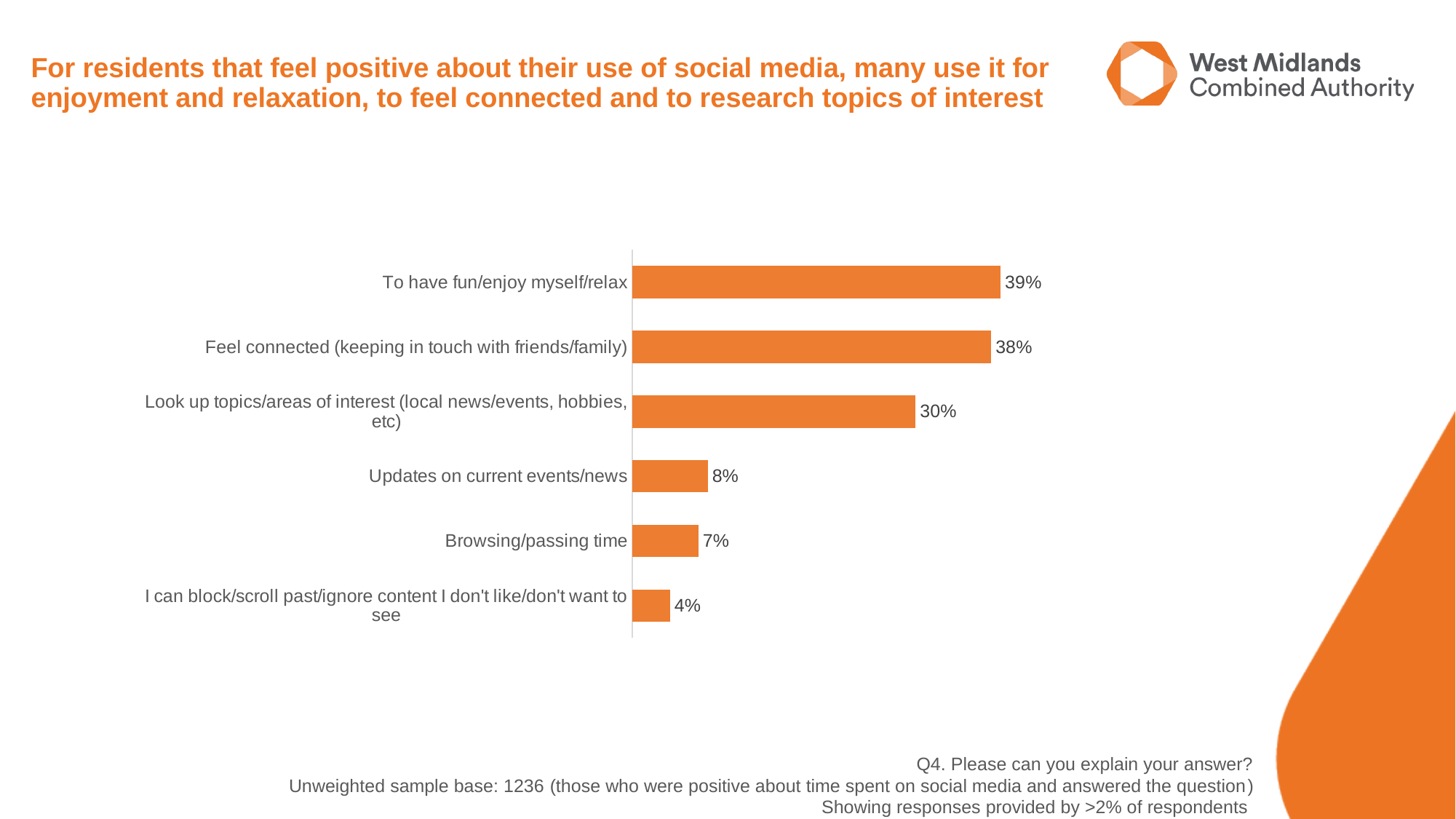
What is the value for 'Feel connected (keeping in touch with friends/family)'? 38% How many categories are shown in the chart? 6 What type of chart is shown on the slide? Bar chart Which category has the lowest value? I can block/scroll past/ignore content I don't like/don't want to see What is the unweighted sample base stated on the slide? 1236 Which category has the highest value? To have fun/enjoy myself/relax What is the difference between 'Updates on current events/news' and 'I can block/scroll past/ignore content I don't like/don't want to see'? 4% Which is larger: the value for 'Updates on current events/news' or 'Browsing/passing time'? Updates on current events/news What percentage of respondents said they use social media to have fun/enjoy myself/relax? 39% What is the value for 'Browsing/passing time'? 7% What is the difference between the values for 'To have fun/enjoy myself/relax' and 'Look up topics/areas of interest (local news/events, hobbies, etc)'? 9% What percentage is shown for 'Look up topics/areas of interest (local news/events, hobbies, etc)'? 30%